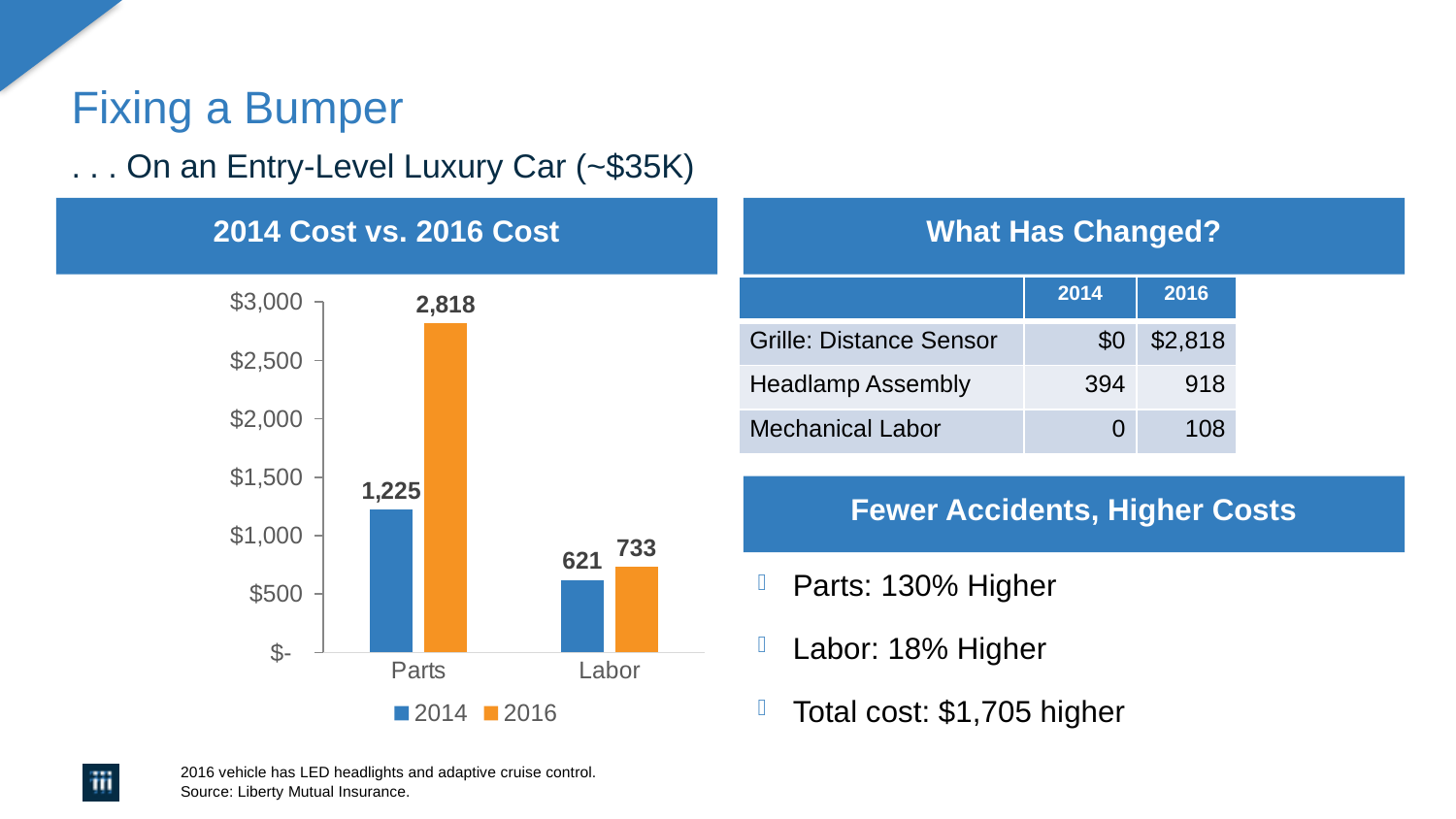
Which is larger, the 2014 value for Parts or the 2016 value for Labor? 2014 value for Parts How many series does the legend list? 2 What is the title of the chart? 2014 Cost vs. 2016 Cost Which category has the highest 2016 value? Parts What is the difference between the 2016 and 2014 values for Parts? 1,593 What is the 2016 value for Parts? 2,818 What is the 2016 value for Labor? 733 What kind of chart is shown? Bar chart What is the 2014 value for Labor? 621 Which category has the lowest 2014 value? Labor What is the 2014 value for Parts? 1,225 How many categories are shown on the x axis? 2